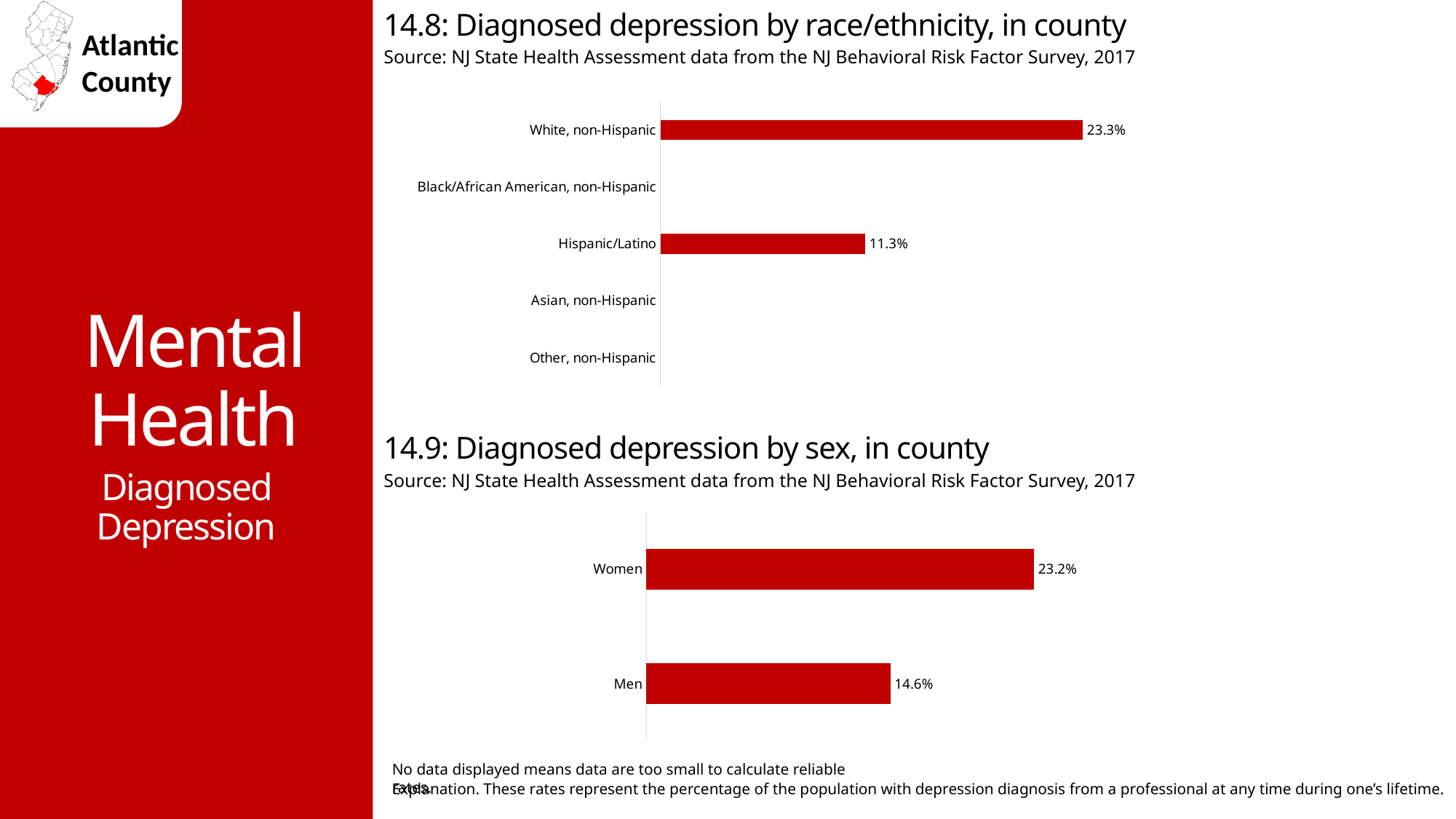
In chart 14.9 (Diagnosed depression by sex), what is the value for Men? 14.6% In chart 14.9 (Diagnosed depression by sex), what is the difference between the Women and Men values? 8.6% In chart 14.9 (Diagnosed depression by sex), what is the value for Women? 23.2% In chart 14.8 (Diagnosed depression by race/ethnicity), what is the value for Hispanic/Latino? 11.3% In chart 14.8 (Diagnosed depression by race/ethnicity), what is the value for White, non-Hispanic? 23.3% In chart 14.8 (Diagnosed depression by race/ethnicity), what is the difference between the White, non-Hispanic and Hispanic/Latino values? 12.0% What kind of chart is chart 14.8 (Diagnosed depression by race/ethnicity)? Bar chart Which is larger: the White, non-Hispanic value in chart 14.8 or the Women value in chart 14.9? White, non-Hispanic (23.3%) In chart 14.8 (Diagnosed depression by race/ethnicity), which category has the highest value? White, non-Hispanic In chart 14.9 (Diagnosed depression by sex), which category has the lowest value? Men In chart 14.8 (Diagnosed depression by race/ethnicity), how many categories are listed on the axis? 5 In chart 14.8 (Diagnosed depression by race/ethnicity), how many categories have a bar displayed? 2